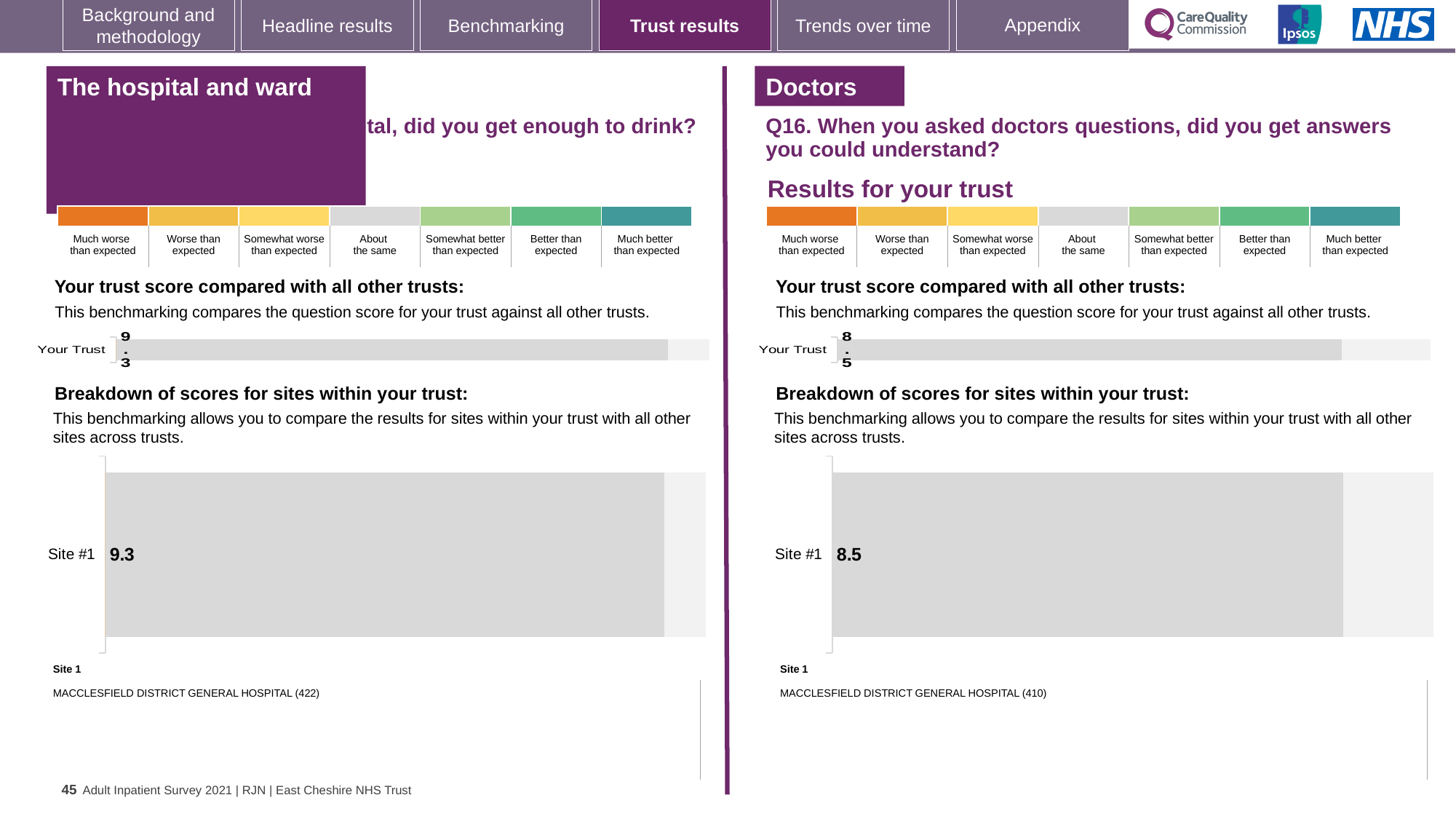
What is the difference between the Site #1 score on the left-hand breakdown chart (9.3) and the Site #1 score on the right-hand Q16 breakdown chart (8.5)? 0.8 How many sites are shown on the right-hand 'Breakdown of scores for sites within your trust' chart under Q16? 1 On the left-hand 'Your trust score compared with all other trusts' chart, what is the score shown for Your Trust? 9.3 On the right-hand 'Your trust score compared with all other trusts' chart under Q16 (Doctors), what is the score shown for Your Trust? 8.5 Which site name is listed as Site 1 beneath the right-hand Q16 breakdown chart? MACCLESFIELD DISTRICT GENERAL HOSPITAL (410) On the right-hand Q16 chart, is the Site #1 score greater or less than 9? less How many sites are shown on the left-hand 'Breakdown of scores for sites within your trust' chart? 1 What kind of chart is used to show the Site #1 score on the right-hand Q16 breakdown chart? Bar chart Which site name is listed as Site 1 beneath the left-hand breakdown chart? MACCLESFIELD DISTRICT GENERAL HOSPITAL (422) Which is larger: the Site #1 score on the left-hand breakdown chart or the Site #1 score on the right-hand (Q16 Doctors) breakdown chart? Left-hand chart (9.3) On the left-hand 'Breakdown of scores for sites within your trust' chart, what is the score for Site #1? 9.3 On the right-hand 'Breakdown of scores for sites within your trust' chart under Q16 (Doctors), what is the score for Site #1? 8.5